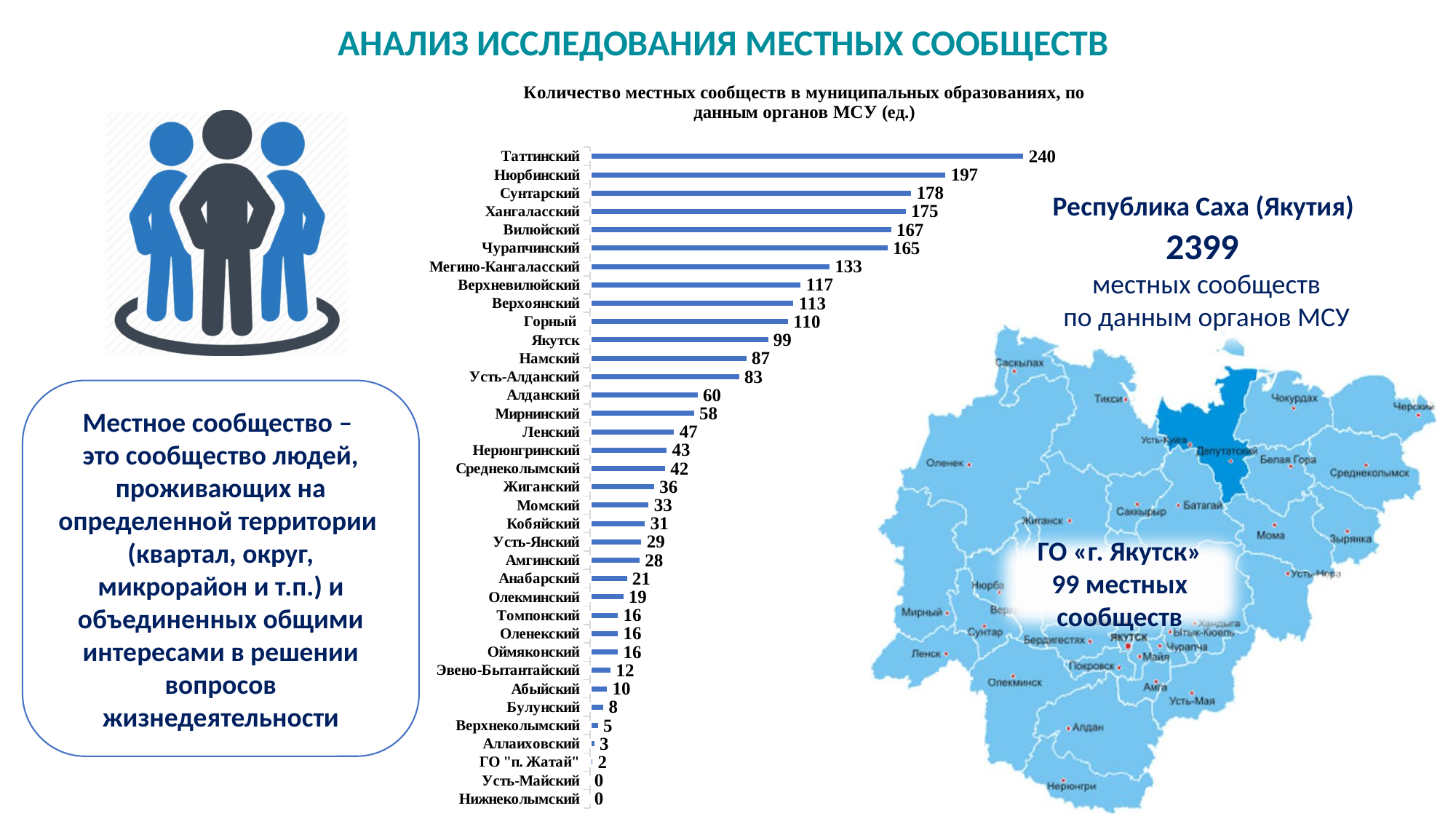
What is the difference between the values for Нюрбинский and Сунтарский? 19 What is the difference between the values for Таттинский and Якутск? 141 What is the title of the chart? Количество местных сообществ в муниципальных образованиях, по данным органов МСУ (ед.) How many categories are shown in the bar chart? 36 What is the value for Якутск? 99 What is the value for Эвено-Бытантайский? 12 What is the value for Таттинский? 240 Which is larger, the value for Вилюйский or the value for Чурапчинский? Вилюйский Which is larger, the value for Алданский or the value for Ленский? Алданский What is the value for Мегино-Кангаласский? 133 Which category has the highest value? Таттинский What kind of chart is shown on the slide? bar chart